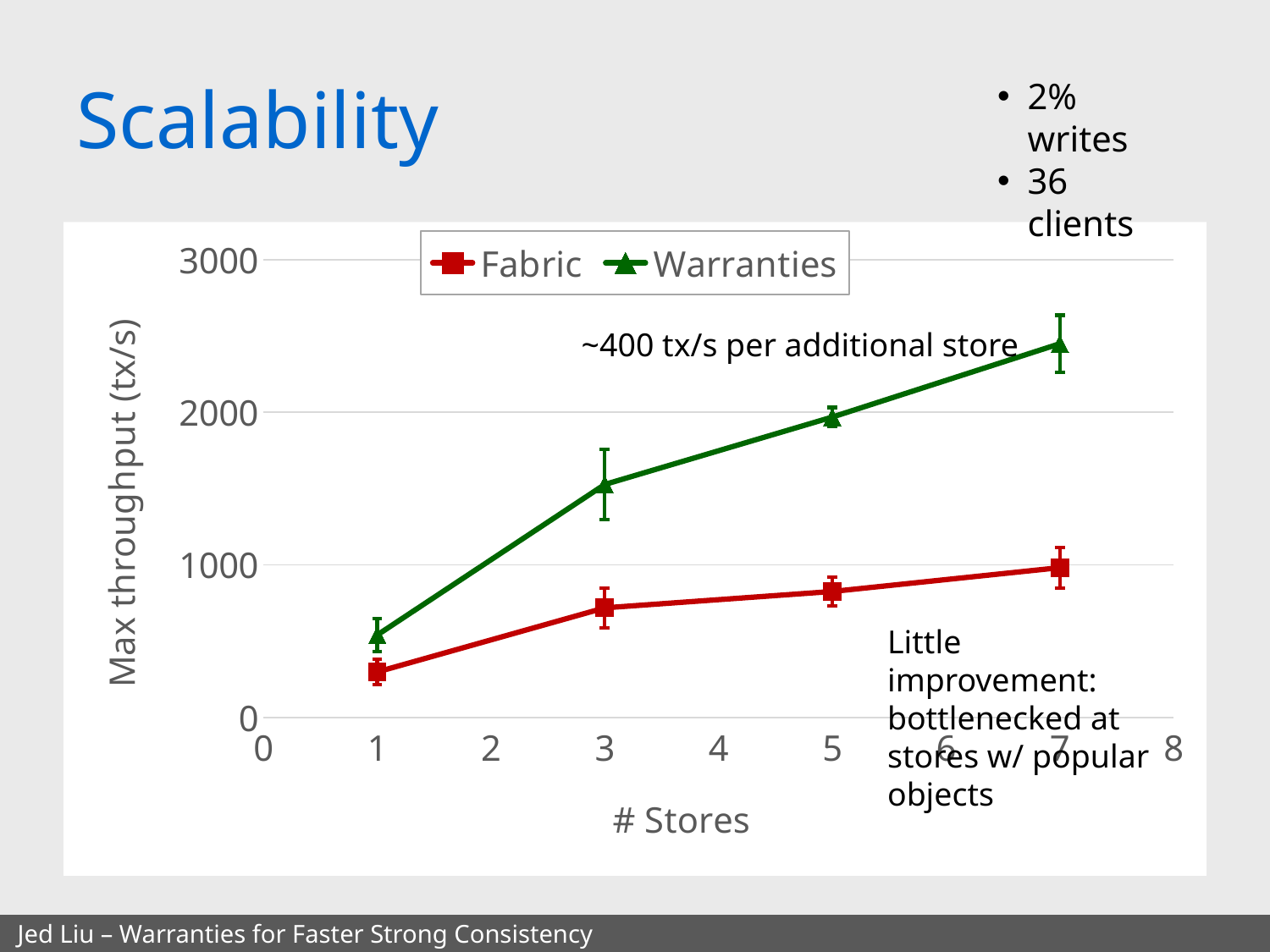
Is the Fabric value at 3 stores greater or less than 1000? less How many series does the legend list? 2 Does the Fabric throughput rise or fall as the number of stores increases? rise What kind of chart is shown on the slide? line chart How many data points are plotted for the Warranties series? 4 Is the Warranties value at 1 store greater or less than 1000? less What is the label of the y axis? Max throughput (tx/s) Is the Warranties value at 7 stores greater or less than 2000? greater At 7 stores, which series has the higher max throughput, Fabric or Warranties? Warranties At how many stores does the Warranties series reach its highest throughput? 7 What are the two series named in the legend? Fabric and Warranties